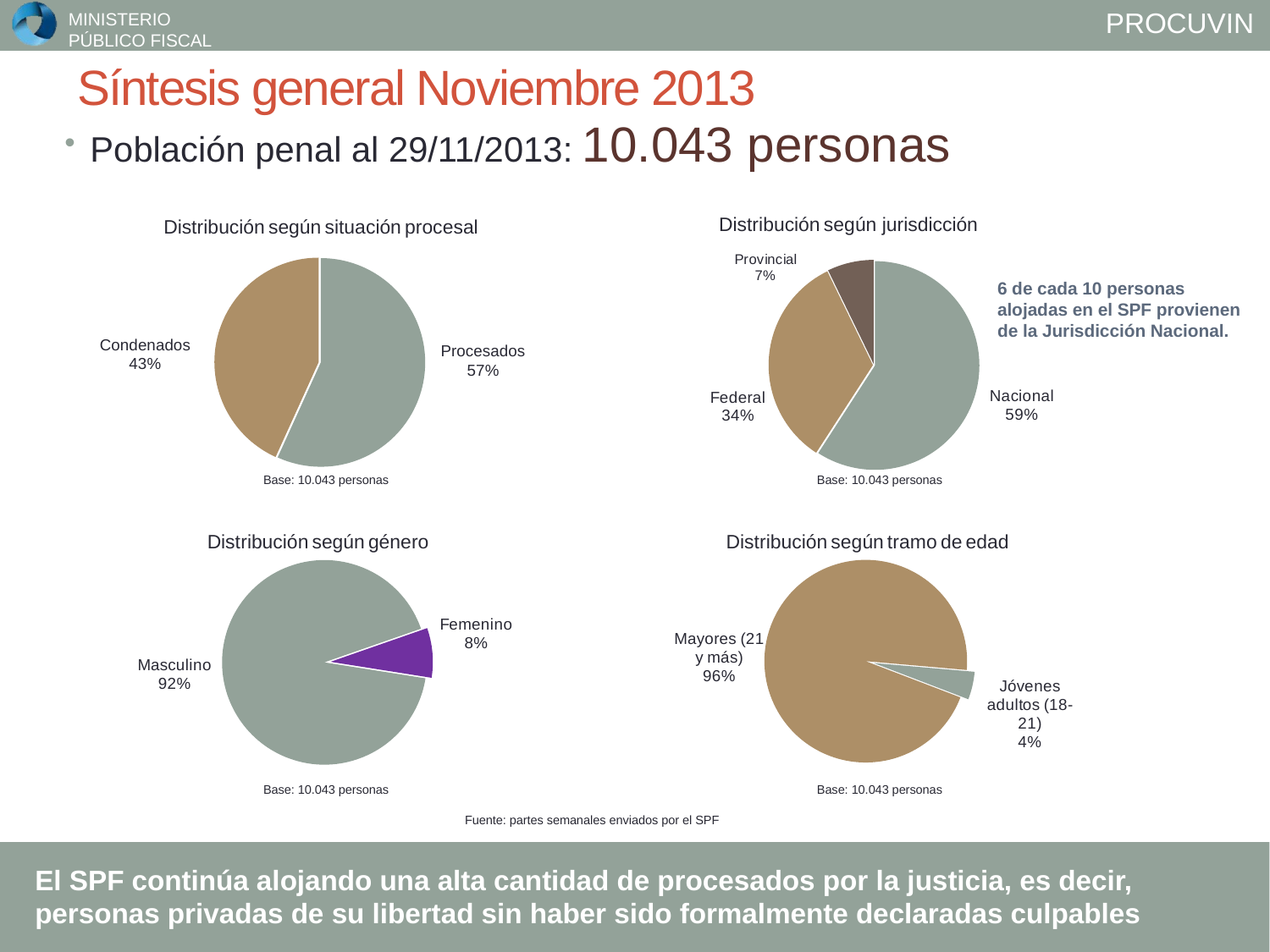
How many charts are on the slide? 4 In the 'Distribución según tramo de edad' chart, what share is Jóvenes adultos (18-21)? 4% What type of chart is 'Distribución según tramo de edad'? Pie chart In the 'Distribución según género' chart, which is larger, Masculino or Femenino? Masculino In the 'Distribución según jurisdicción' chart, which category has the largest share? Nacional In the 'Distribución según situación procesal' chart, what share is Procesados? 57% In the 'Distribución según jurisdicción' chart, how many categories are shown? 3 In the 'Distribución según jurisdicción' chart, what is the difference in percentage points between Nacional and Federal? 25 In the 'Distribución según jurisdicción' chart, which category has the smallest share? Provincial In the 'Distribución según género' chart, what share is Femenino? 8% In the 'Distribución según situación procesal' chart, what share is Condenados? 43% In the 'Distribución según jurisdicción' chart, what share is Federal? 34%